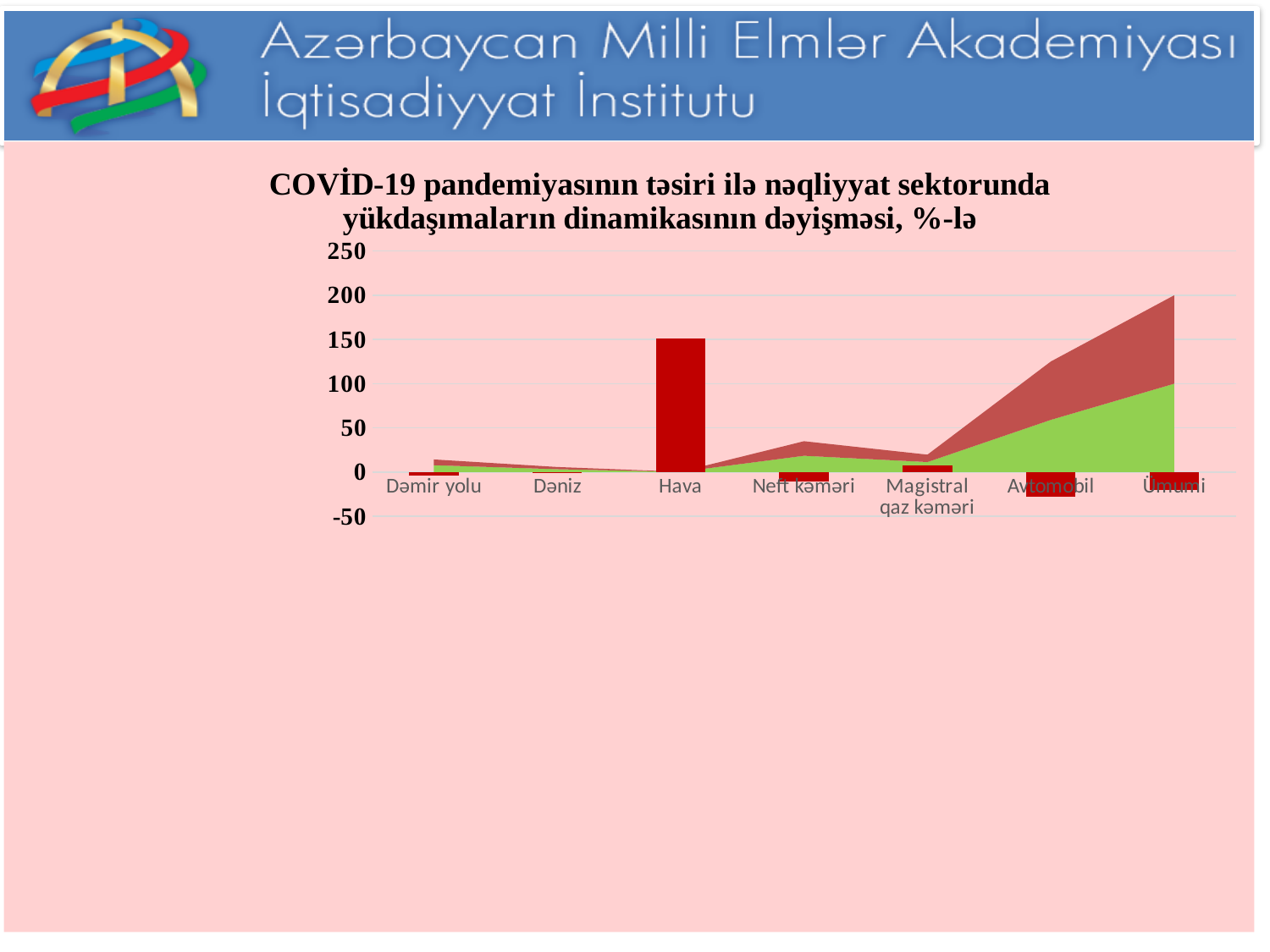
What is the title of the chart? COVİD-19 pandemiyasının təsiri ilə nəqliyyat sektorunda yükdaşımaların dinamikasının dəyişməsi, %-lə Is the bar value for Ümumi greater or less than 0? less Which category has the lowest bar in the chart? Avtomobil What is the highest tick value shown on the y axis of the chart? 250 Is the bar value for Hava greater or less than 100? greater Which category has the tallest bar in the chart? Hava Is the bar value for Dəmir yolu greater or less than 50? less How many categories are shown on the x axis of the chart? 7 Does the stacked area rise or fall from Magistral qaz kəməri to Ümumi? rise Which has the larger bar, Hava or Magistral qaz kəməri? Hava